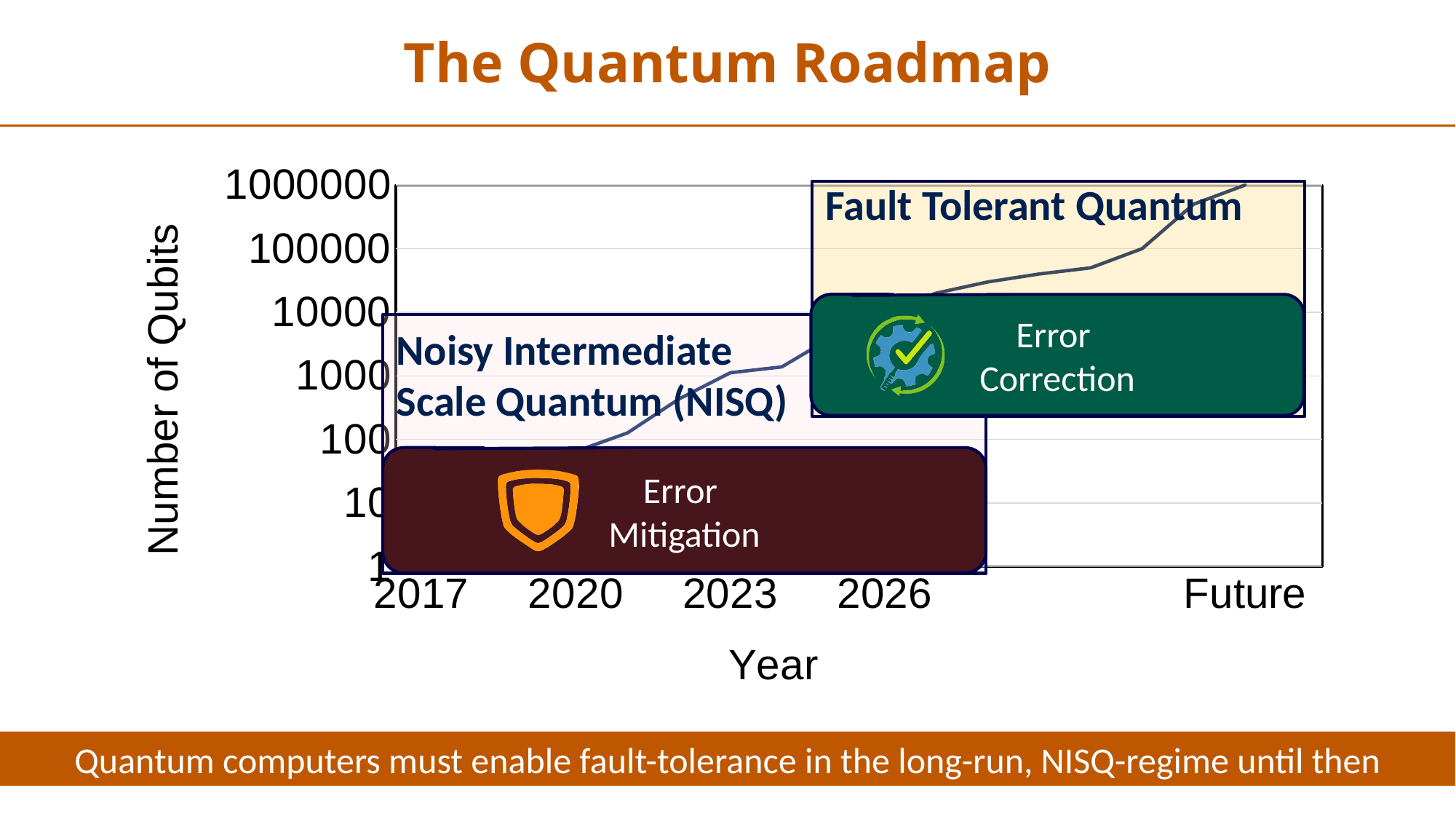
What is the highest value labelled on the y axis of the chart? 1000000 Which has the larger number of qubits on the chart, 2020 or Future? Future What is the title of the x axis of the chart? Year Is the value for 2020 greater or less than 1000? less Is the value for Future greater or less than 100000? greater What is the title of the y axis of the chart? Number of Qubits What kind of chart is shown on the slide? line chart Which x-axis label comes after 2026 on the chart? Future How many labelled tick marks are there on the x axis of the chart? 5 Do the values on the chart rise or fall as the year increases along the x axis? rise